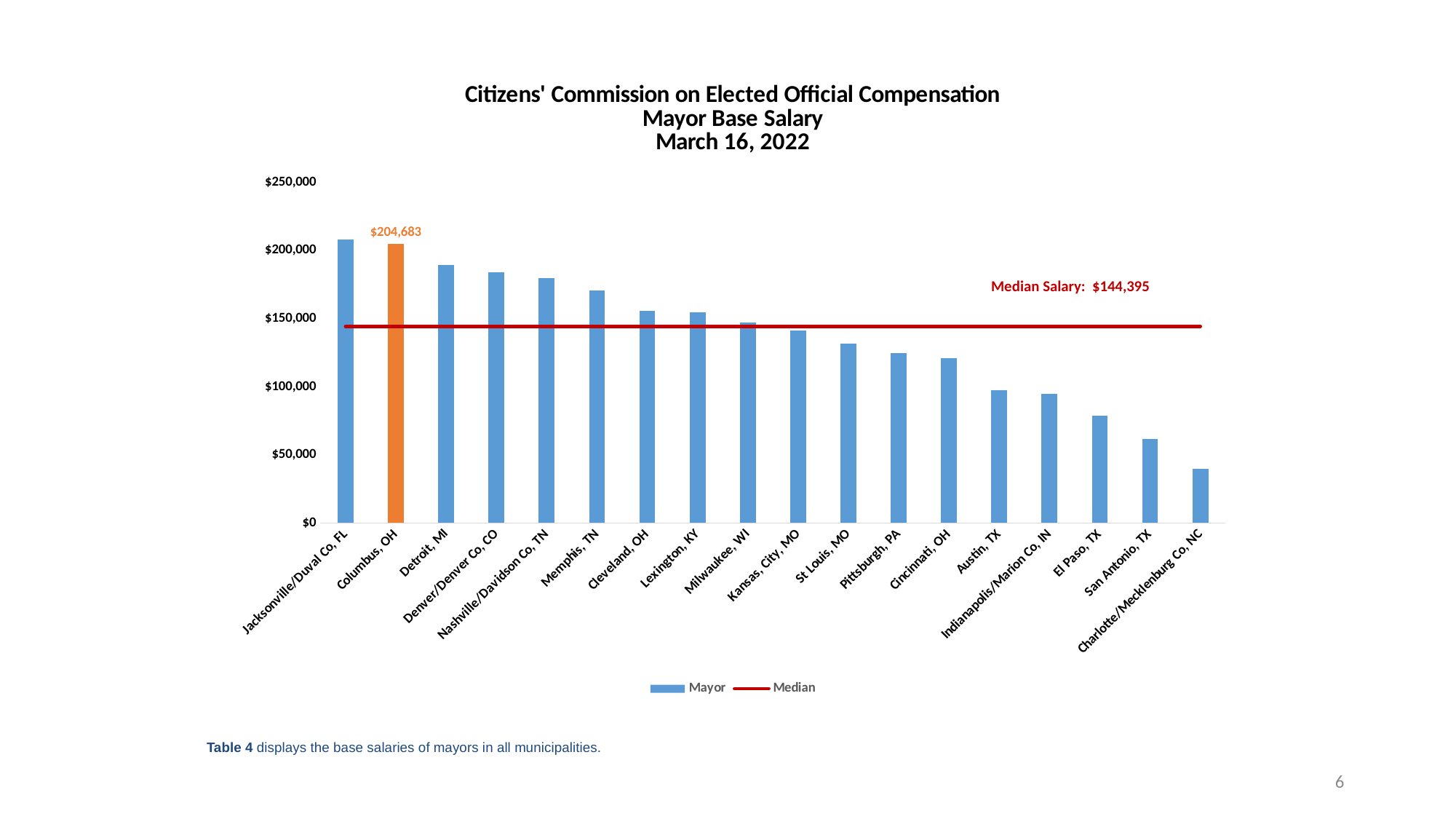
Do the mayor base salaries rise or fall from left to right along the x axis? fall Is the value for Charlotte/Mecklenburg Co, NC greater or less than $50,000? less What is the median salary shown on the chart? $144,395 Is the value for El Paso, TX greater or less than $100,000? less What are the two entries listed in the legend? Mayor and Median What is the mayor base salary shown for Columbus, OH? $204,683 What kind of chart is this? Combination bar and line chart How many municipalities are shown on the x axis? 18 Which has the larger mayor base salary, Detroit, MI or Memphis, TN? Detroit, MI Which municipality has the lowest mayor base salary? Charlotte/Mecklenburg Co, NC How many series does the legend list? 2 Is the value for Detroit, MI greater or less than $150,000? greater